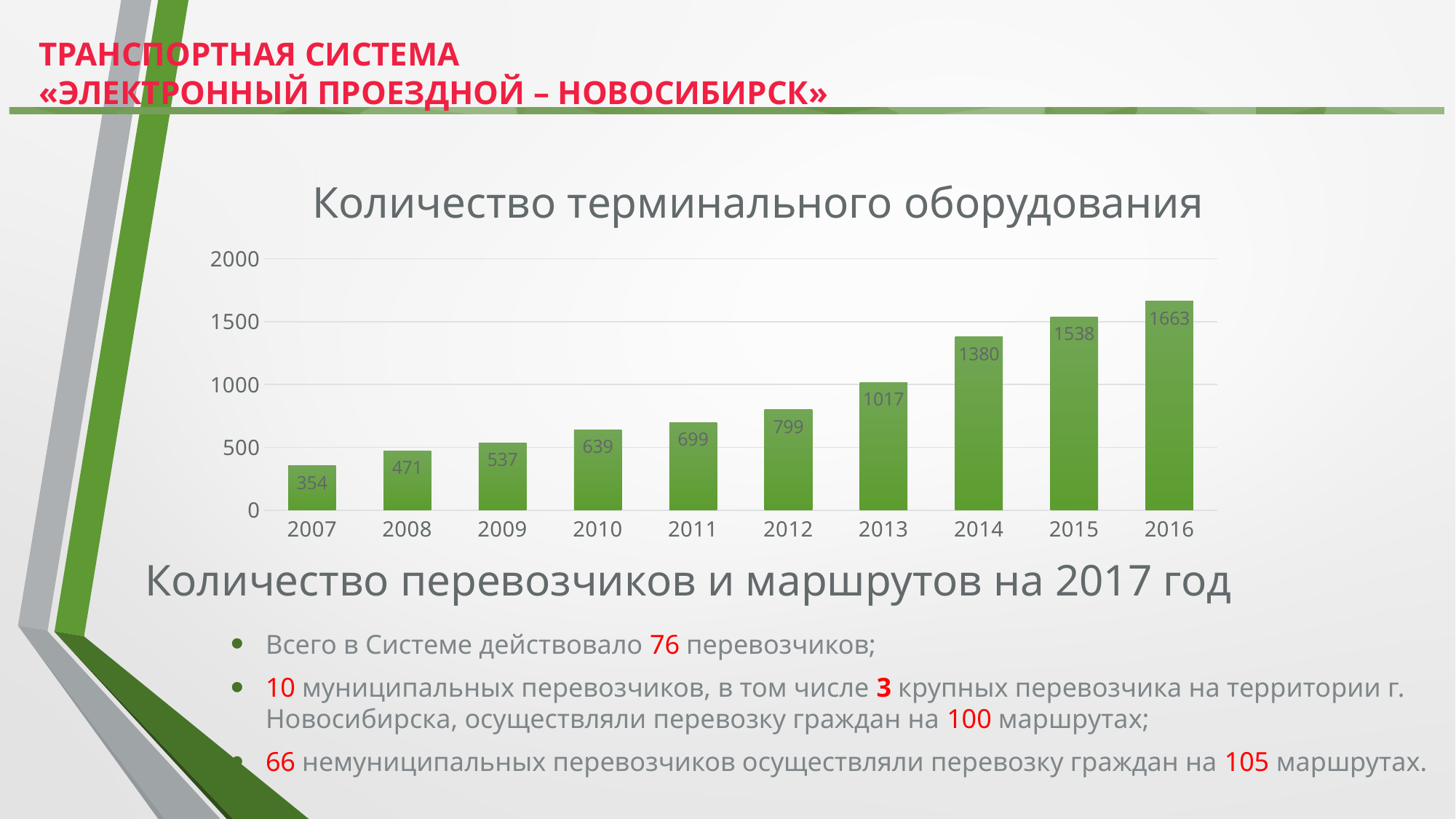
What is the value for 2015 in the chart? 1538 Is the value for 2013 greater or less than 1000? greater What is the difference between the values for 2016 and 2015? 125 What is the difference between the values for 2014 and 2013? 363 Do the values rise or fall from 2007 to 2016? rise What is the value for 2007 in the chart? 354 What kind of chart is shown on the slide? bar chart Which is larger, the value for 2010 or the value for 2011? 2011 How many years are shown on the x axis of the chart? 10 Which year has the highest value in the chart? 2016 Which year has the lowest value in the chart? 2007 What is the value for 2012 in the chart? 799